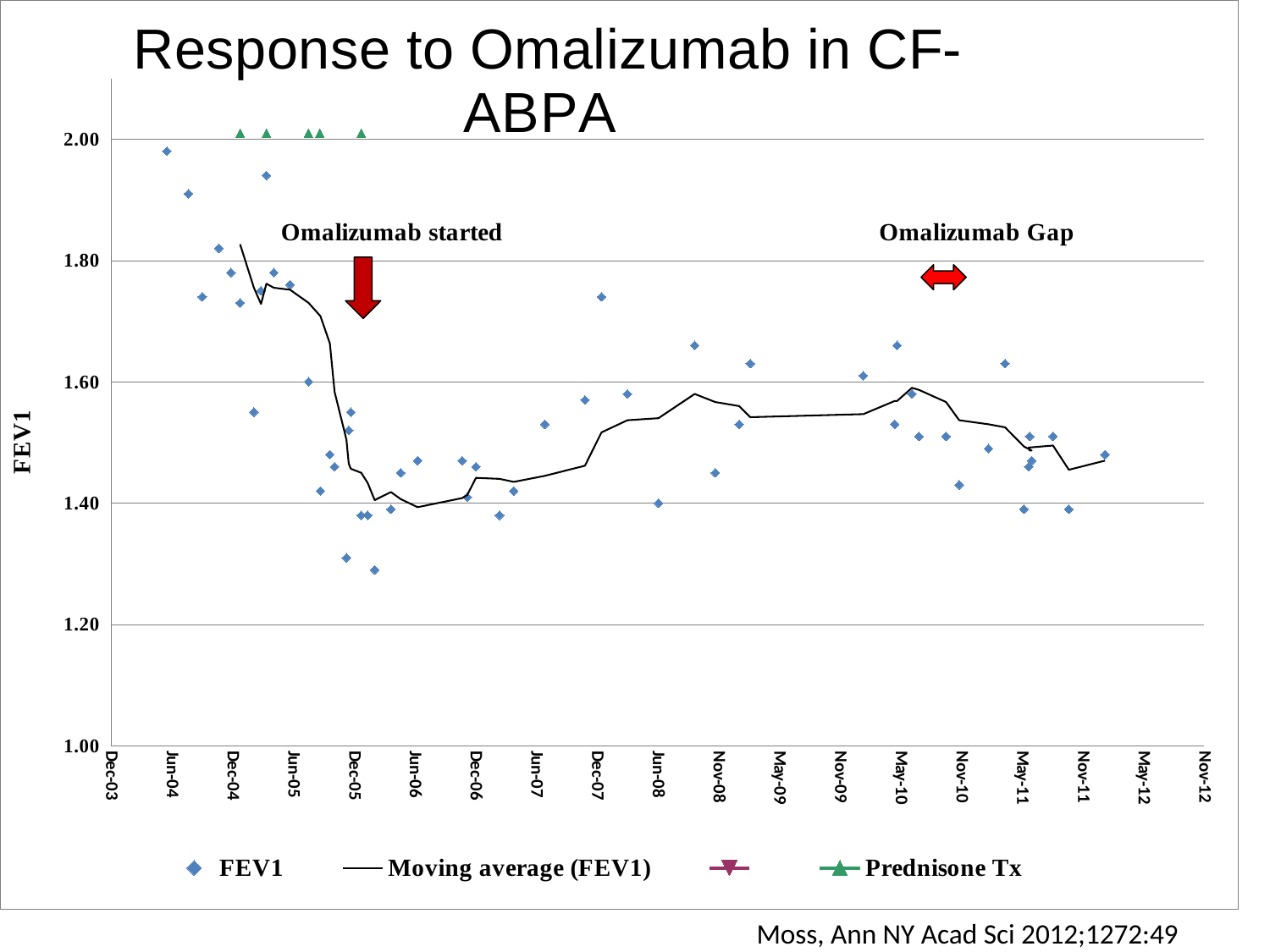
What is the lowest value shown on the vertical axis? 1.00 Does the moving average (FEV1) line rise or fall between Dec-04 and Dec-05? fall Is the lowest FEV1 data point greater or less than 1.40? less Is the highest FEV1 data point greater or less than 1.90? greater What is the highest value shown on the vertical axis? 2.00 Is the FEV1 data point at Jun-04 greater or less than 1.80? greater Which series is drawn as a black line in the chart? Moving average (FEV1) What kind of chart is shown on the slide? Scatter chart with a moving average line Does the moving average (FEV1) line rise or fall between Dec-06 and Nov-08? rise What is the label on the vertical axis? FEV1 What is the title of the chart on the slide? Response to Omalizumab in CF-ABPA Which series is shown with green triangle markers near the top of the chart? Prednisone Tx